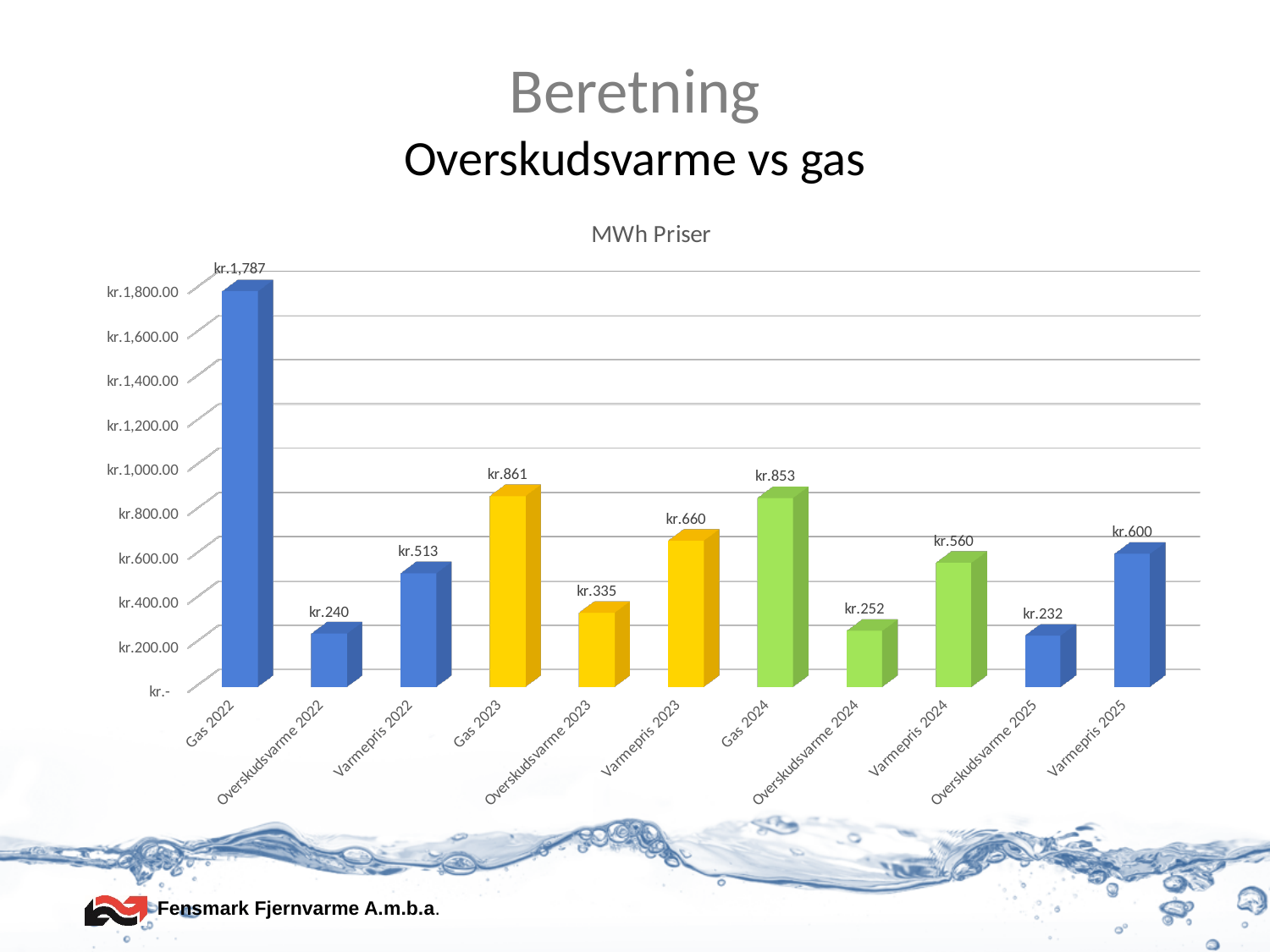
What is the value for Overskudsvarme 2023? kr.335 What is the difference between Varmepris 2025 and Varmepris 2024? kr.40 What is the title of the chart? MWh Priser What is the value for Varmepris 2025? kr.600 Which category has the highest value? Gas 2022 What is the difference between Gas 2023 and Overskudsvarme 2023? kr.526 Which category has the lowest value? Overskudsvarme 2025 What kind of chart is shown? Bar chart Is the value for Gas 2024 greater or less than kr.800.00? greater How many categories are shown on the x axis? 11 Which is larger, Varmepris 2023 or Varmepris 2022? Varmepris 2023 What is the value for Gas 2022? kr.1,787